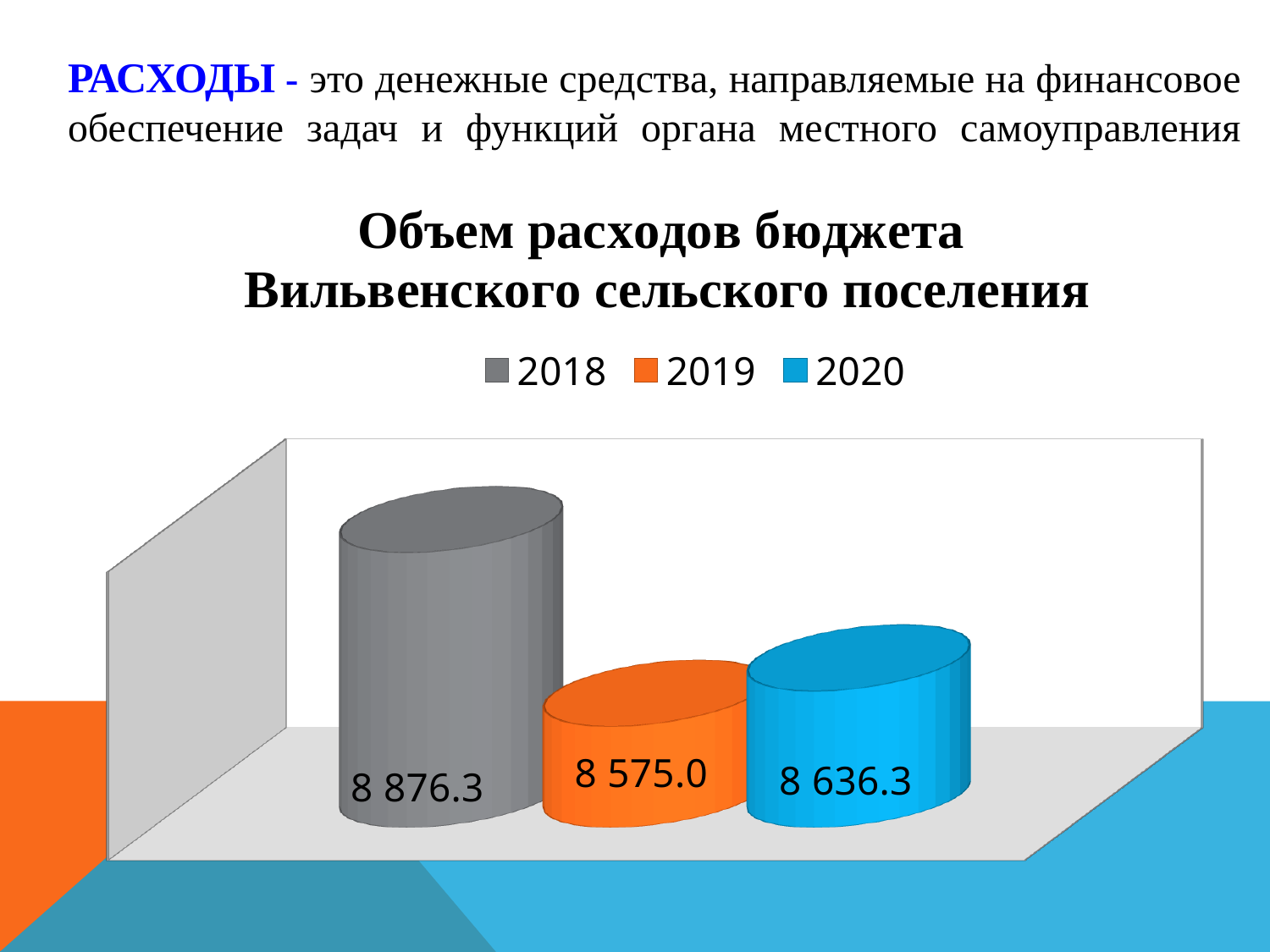
What is the value shown for 2020? 8 636.3 Which year has the lowest value? 2019 What is the difference between the values for 2018 and 2019? 301.3 What is the difference between the values for 2018 and 2020? 240.0 What is the value shown for 2018? 8 876.3 How many series does the legend list? 3 What colour represents 2019 in the legend? orange What is the difference between the values for 2020 and 2019? 61.3 Which year has the highest value? 2018 Which is larger, the value for 2019 or the value for 2020? 2020 What kind of chart is shown on the slide? bar chart What is the value shown for 2019? 8 575.0